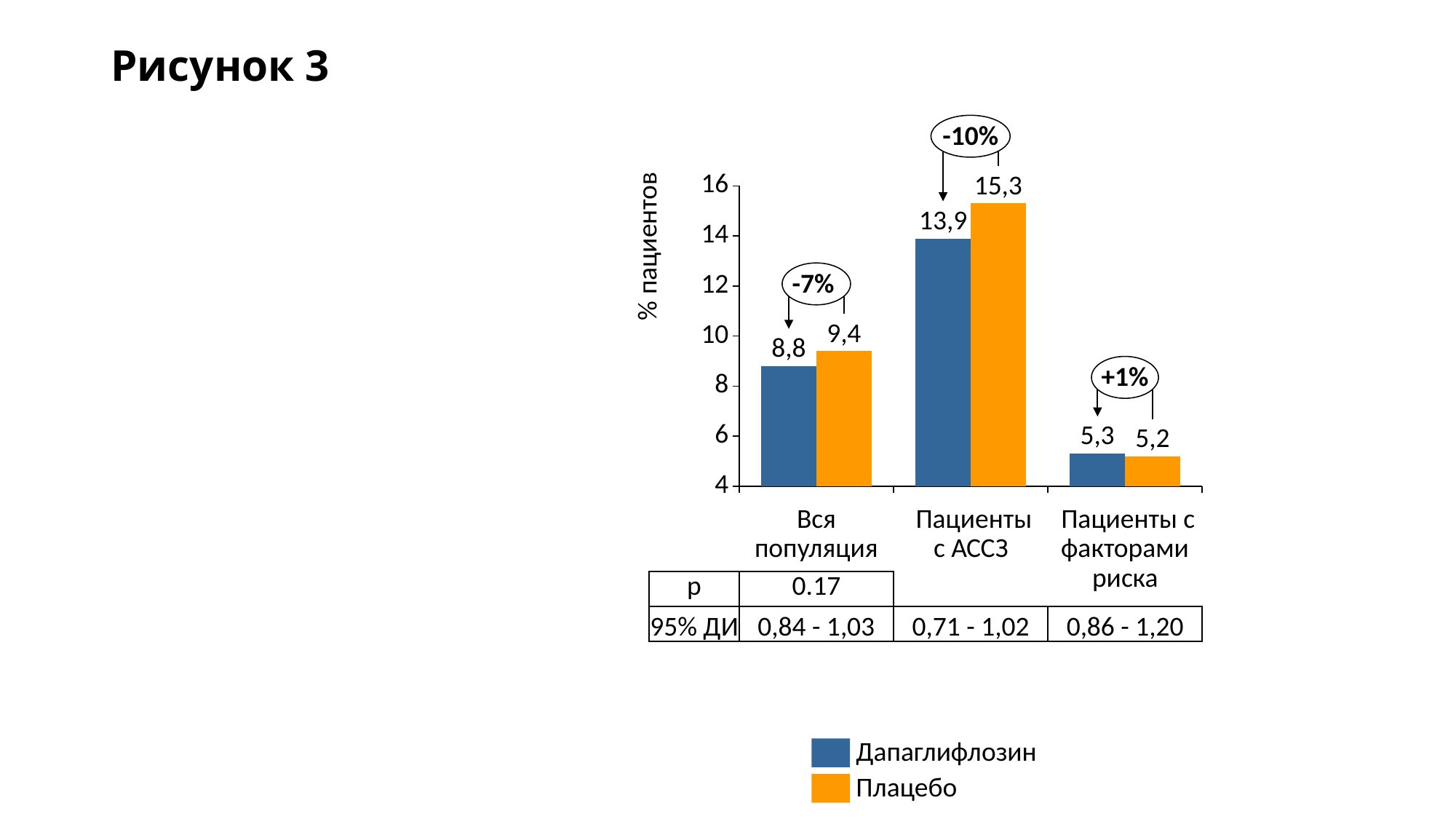
What kind of chart is shown on the slide? bar chart What is the value for Дапаглифлозин in the Пациенты с факторами риска category? 5,3 How many series does the legend list? 2 In the Вся популяция category, which series has the larger value, Дапаглифлозин or Плацебо? Плацебо How many categories are shown on the x axis? 3 What is the value for Плацебо in the Пациенты с АССЗ category? 15,3 What is the value for Дапаглифлозин in the Вся популяция category? 8,8 What is the y-axis label of the chart? % пациентов Which category has the lowest value for Дапаглифлозин? Пациенты с факторами риска What is the difference between the Плацебо and Дапаглифлозин values in the Пациенты с АССЗ category? 1,4 Is the value for Дапаглифлозин in the Пациенты с АССЗ category greater or less than 12? greater Which category has the highest value for Плацебо? Пациенты с АССЗ